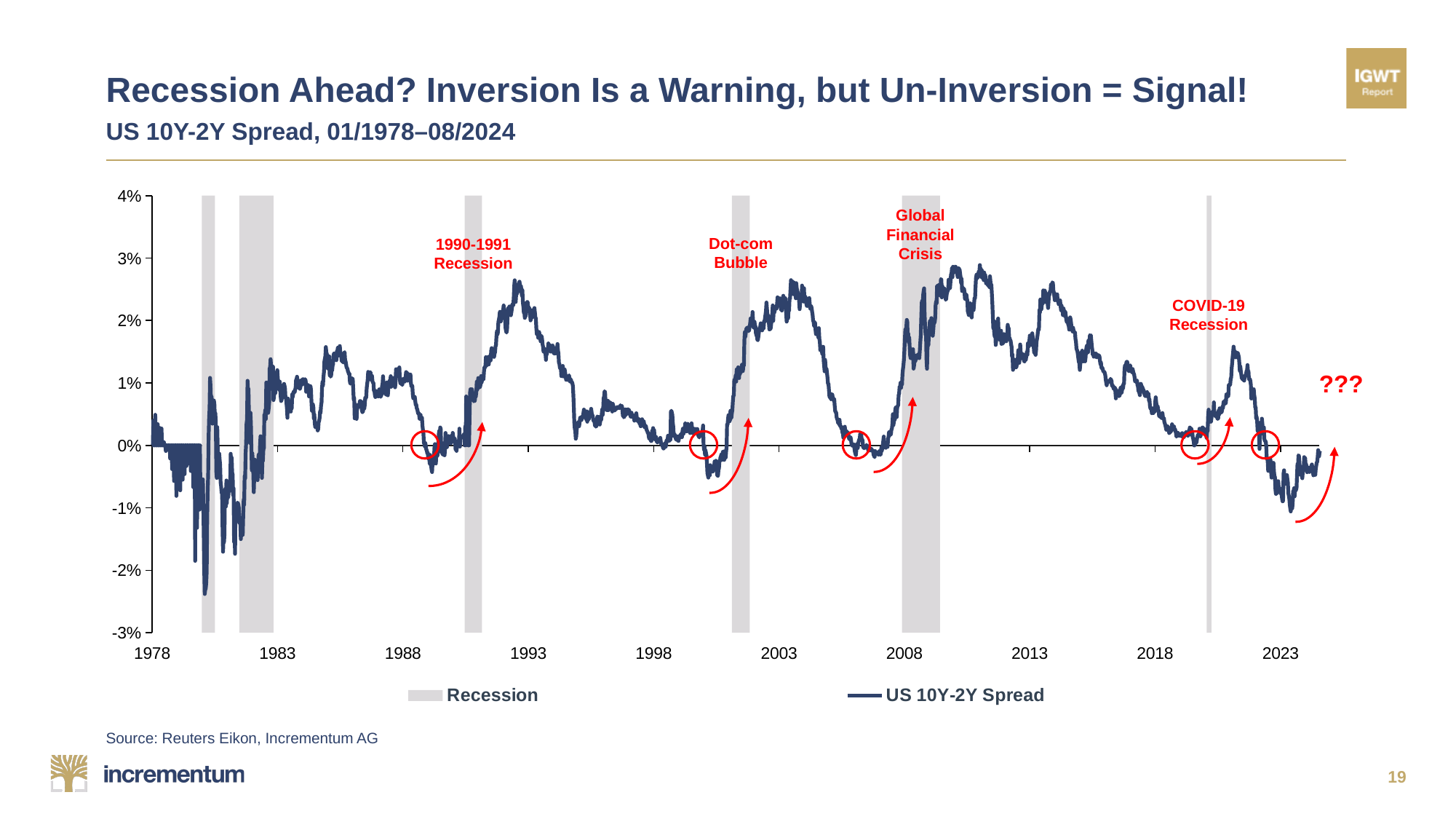
Between 2019 and 2021, does the US 10Y-2Y Spread rise or fall? rise How many shaded recession bands are shown on the chart? 6 What kind of chart is shown on the slide? line chart Is the peak value of the US 10Y-2Y Spread around 2010 greater or less than 2%? greater How many entries does the chart legend list? 2 Is the peak value of the US 10Y-2Y Spread around 1992 greater or less than 2%? greater What is the name of the data series plotted as the dark line? US 10Y-2Y Spread Between 2010 and 2019, does the US 10Y-2Y Spread generally rise or fall? fall Which is higher: the peak of the US 10Y-2Y Spread around 2010 or the peak around 2021? the peak around 2010 Is the value of the US 10Y-2Y Spread in 2023 greater or less than 0%? less What event is labeled in red above the shaded band around 2001? Dot-com Bubble